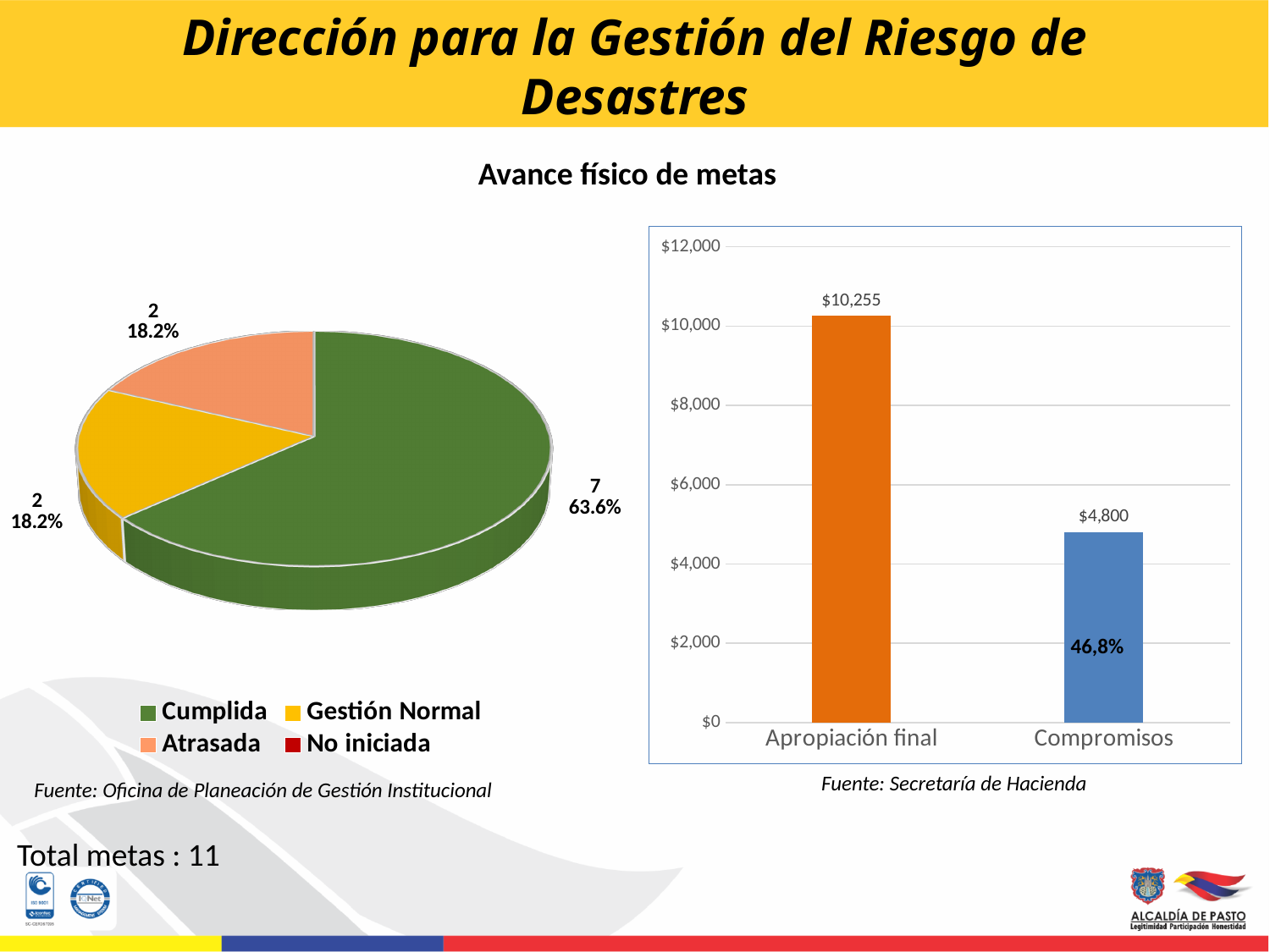
In the pie chart on the left, what value is shown for the Cumplida slice? 7 How many entries does the legend of the pie chart on the left list? 4 In the bar chart on the right, what is the value for Apropiación final? $10,255 In the bar chart on the right, what percentage label is printed on the Compromisos bar? 46,8% In the bar chart on the right, what is the difference between Apropiación final and Compromisos? $5,455 What kind of chart is the chart on the left of the slide? Pie chart How many bars are plotted in the bar chart on the right? 2 In the pie chart on the left, what share of the pie does the Cumplida slice represent? 63.6% In the bar chart on the right, what is the value for Compromisos? $4,800 In the pie chart on the left, what percentage is shown for the Atrasada slice? 18.2% In the bar chart on the right, which is larger, Apropiación final or Compromisos? Apropiación final In the pie chart on the left, which category has the largest slice? Cumplida